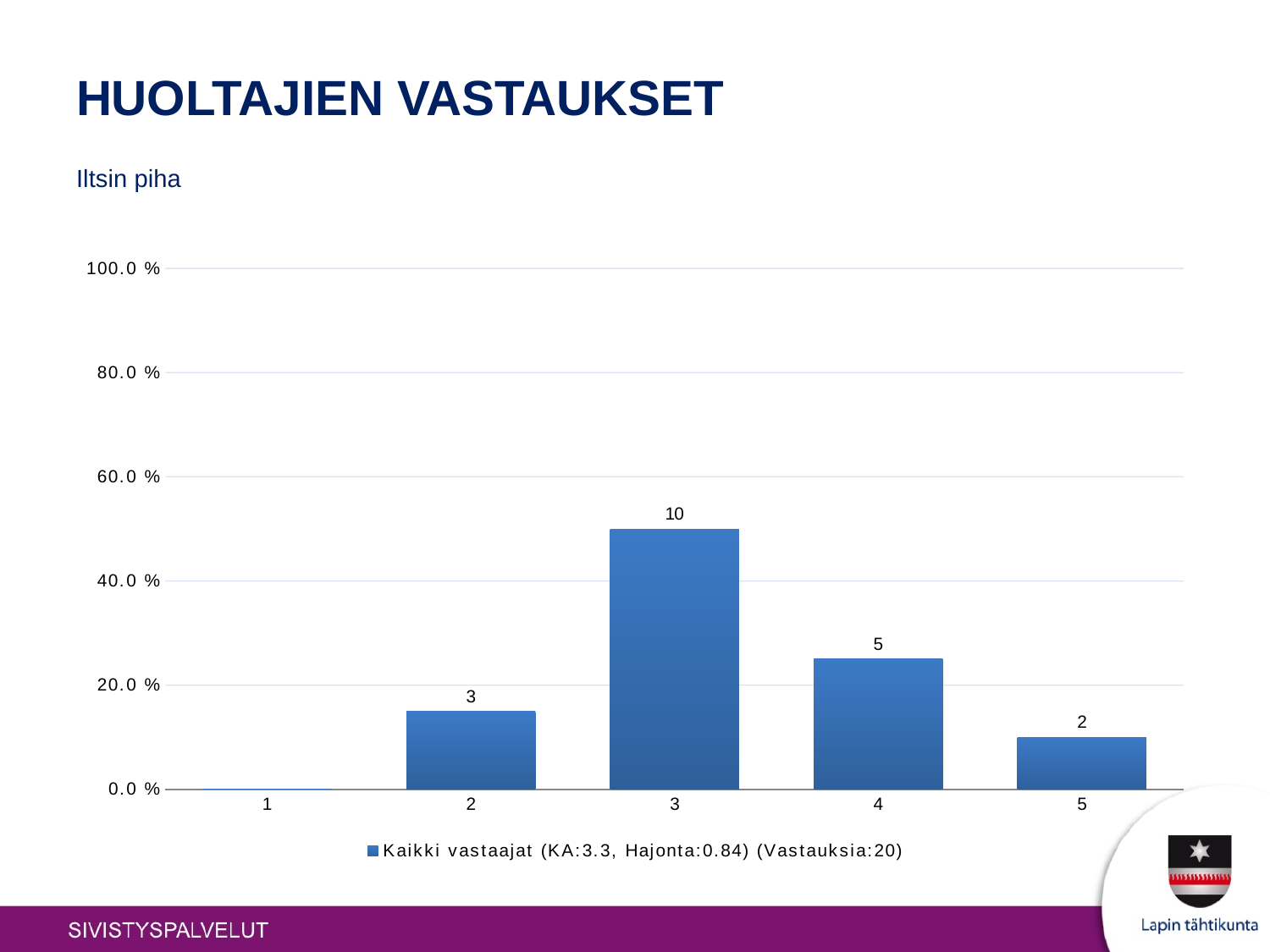
How many categories are shown on the x axis? 5 Which category has the highest bar? 3 What kind of chart is shown on the slide? bar chart Is the value for category 3 greater or less than 40.0 %? greater Is the value for category 2 greater or less than 20.0 %? less What is the data label on the bar for category 2? 3 Which category has the lowest bar? 1 What is the data label on the bar for category 5? 2 What is the data label on the bar for category 4? 5 What is the difference between the data labels for category 3 and category 4? 5 What is the data label on the bar for category 3? 10 Which has a larger value, category 4 or category 5? 4